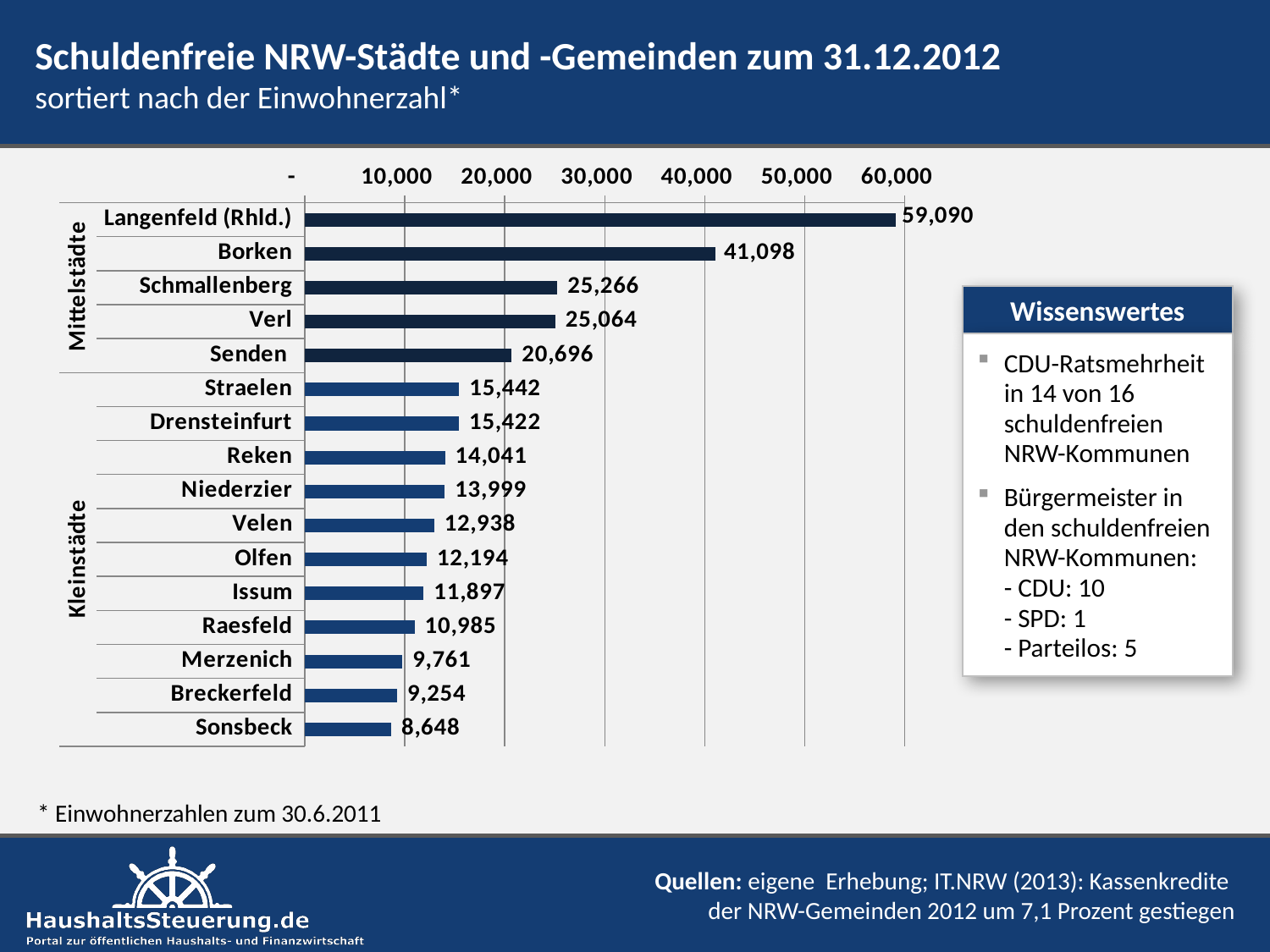
How many municipalities are shown in the chart? 16 Is the value for Borken greater or less than 40,000? greater What is the difference in population between Langenfeld (Rhld.) and Borken? 17,992 Which municipality has the lowest population in the chart? Sonsbeck What kind of chart is shown on the slide? bar chart What is the difference in population between Schmallenberg and Verl? 202 What is the population value shown for Senden? 20,696 How many municipalities are grouped under Mittelstädte in the chart? 5 Which has a larger population, Borken or Schmallenberg? Borken Which municipality has the highest population in the chart? Langenfeld (Rhld.) What is the population value shown for Raesfeld? 10,985 What is the population value shown for Langenfeld (Rhld.)? 59,090